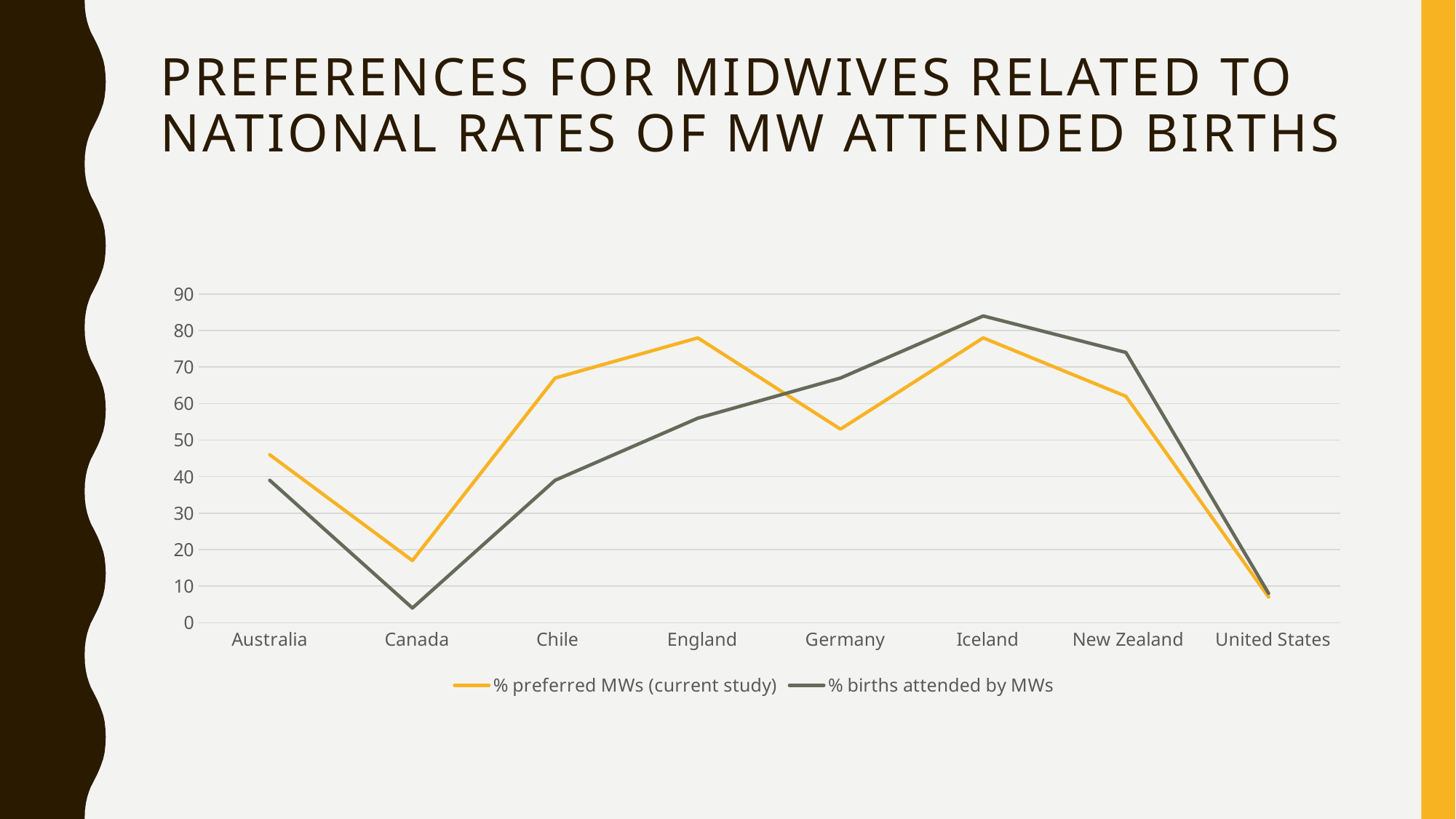
How many countries are shown on the x axis of the chart? 8 Does the % preferred MWs (current study) line rise or fall from Canada to England? rise Is the value for % births attended by MWs in Iceland greater or less than 80? greater Is the value for % preferred MWs (current study) in England greater or less than 70? greater What kind of chart is shown on the slide? line chart What colour is the line for % births attended by MWs? grey Which country has the lowest value for % preferred MWs (current study)? United States Is the value for % births attended by MWs in Canada greater or less than 10? less For Germany, which is larger: % preferred MWs (current study) or % births attended by MWs? % births attended by MWs For Chile, which is larger: % preferred MWs (current study) or % births attended by MWs? % preferred MWs (current study) Which country has the highest value for % births attended by MWs? Iceland How many series does the chart's legend list? 2